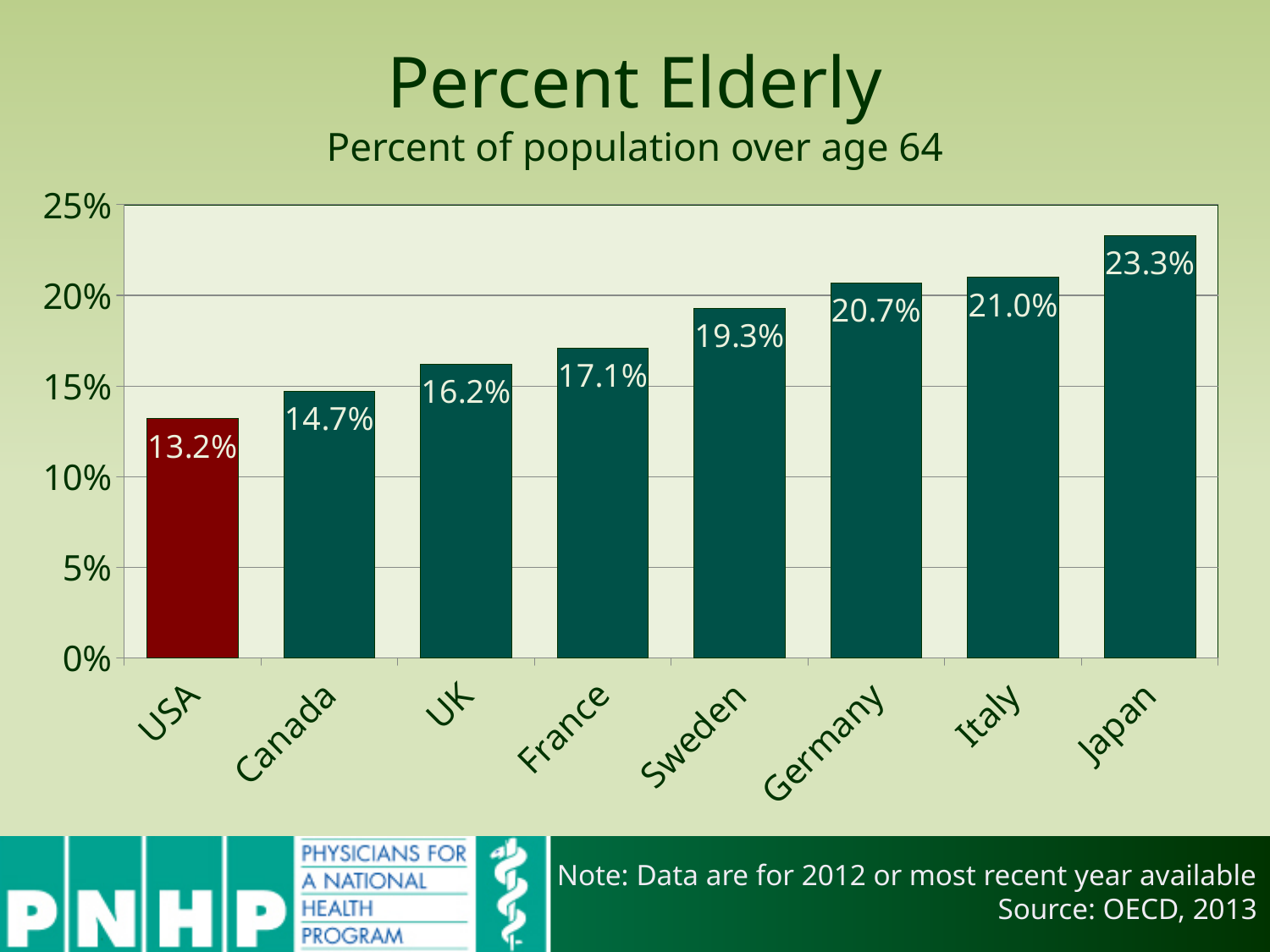
Do the values rise or fall moving from left to right along the x axis? rise Which country has the lowest percent of population over age 64? USA What is the percent elderly value for Germany? 20.7% Which country has the highest percent of population over age 64? Japan Which country's bar is coloured differently (red) from the others? USA Is the value for Italy greater or less than 20%? greater What is the percent elderly value for the USA? 13.2% What is the difference in percent elderly between Canada and the UK? 1.5% What kind of chart is shown on the slide? bar chart Which has a higher percent elderly, Sweden or France? Sweden What is the difference in percent elderly between Japan and the USA? 10.1% How many countries are shown in the chart? 8